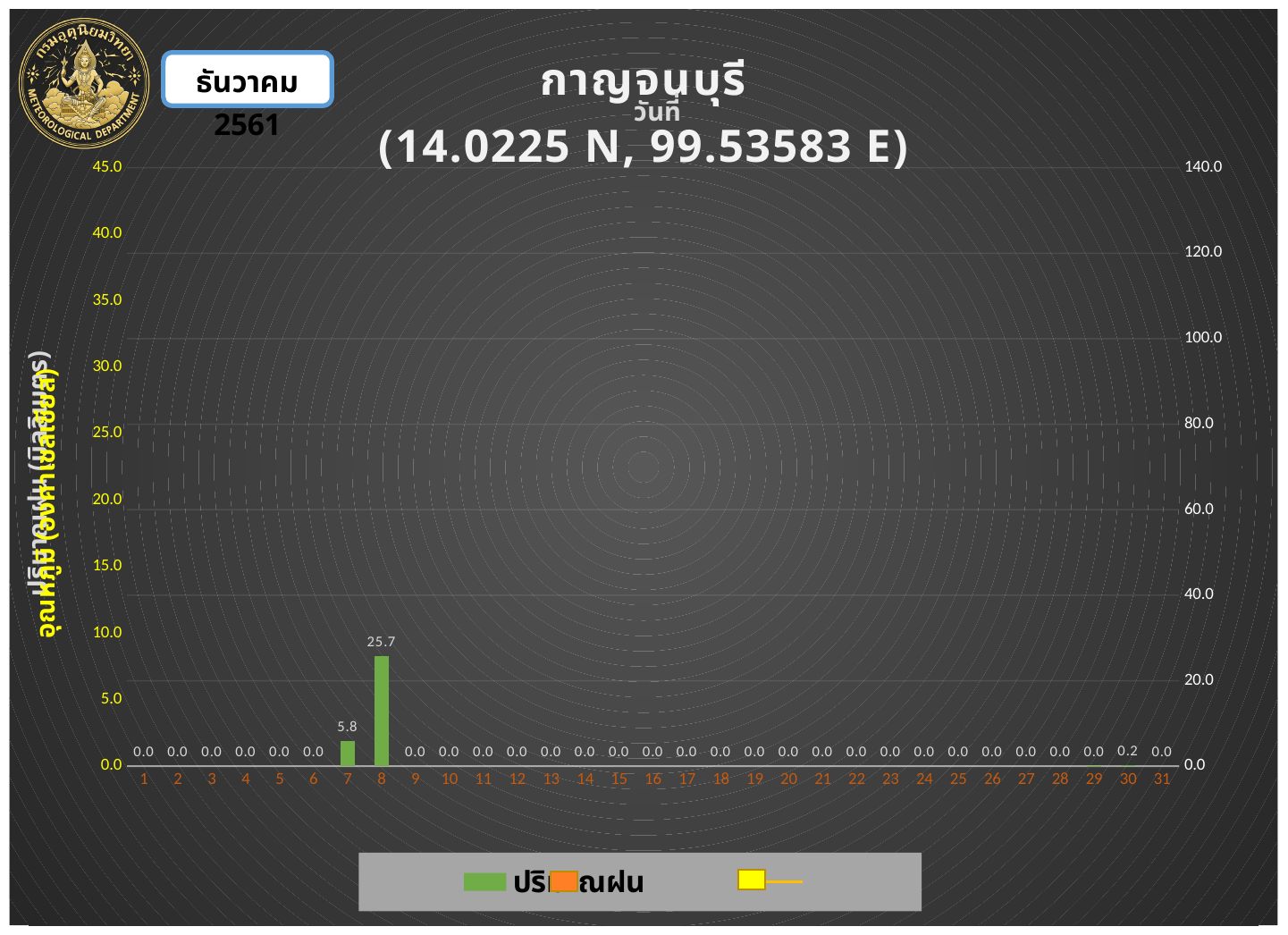
Which day has the highest rainfall value? 8 What is the rainfall value for day 8? 25.7 What is the rainfall value for day 30? 0.2 What is the difference between the rainfall values for day 8 and day 7? 19.9 What is the highest tick value shown on the left vertical axis? 45.0 What coordinates are given in the chart title? 14.0225 N, 99.53583 E How many days are shown on the x axis? 31 What kind of chart is shown on the slide? bar chart What is the rainfall value for day 7? 5.8 What is the rainfall value for day 15? 0.0 Which has the larger rainfall value, day 7 or day 30? day 7